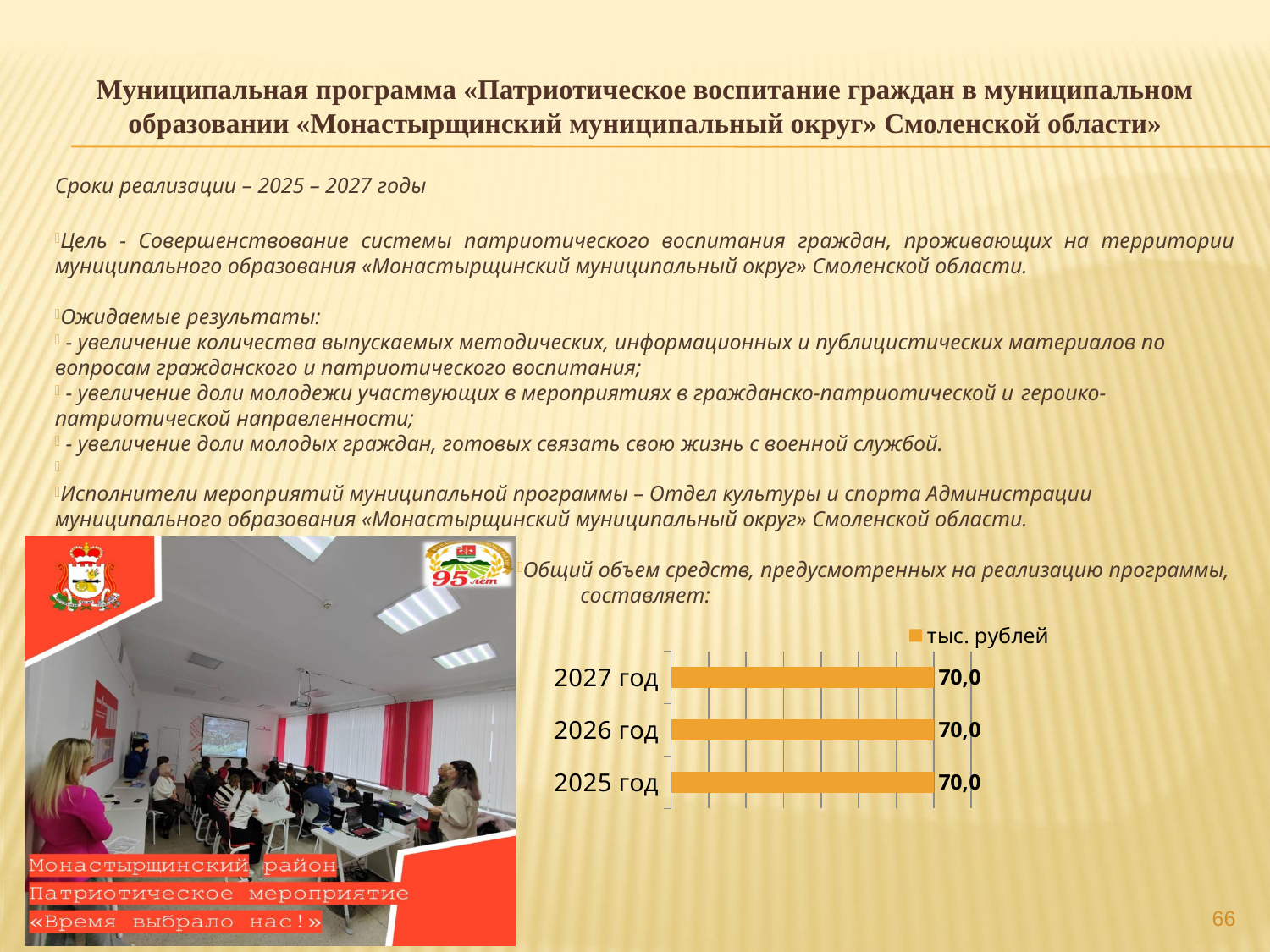
What is the value for 2026 год in the chart? 70,0 What colour are the bars in the chart? orange How many categories (years) are shown in the chart? 3 Do the values rise, fall or stay the same from 2025 год to 2027 год? stay the same What kind of chart is shown on the slide? bar chart What is the name of the series shown in the chart legend? тыс. рублей What is the value for 2027 год in the chart? 70,0 What is the difference between the values for 2027 год and 2025 год? 0,0 Is the value for 2026 год larger than, smaller than, or equal to the value for 2025 год? equal What is the value for 2025 год in the chart? 70,0 How many series does the chart legend list? 1